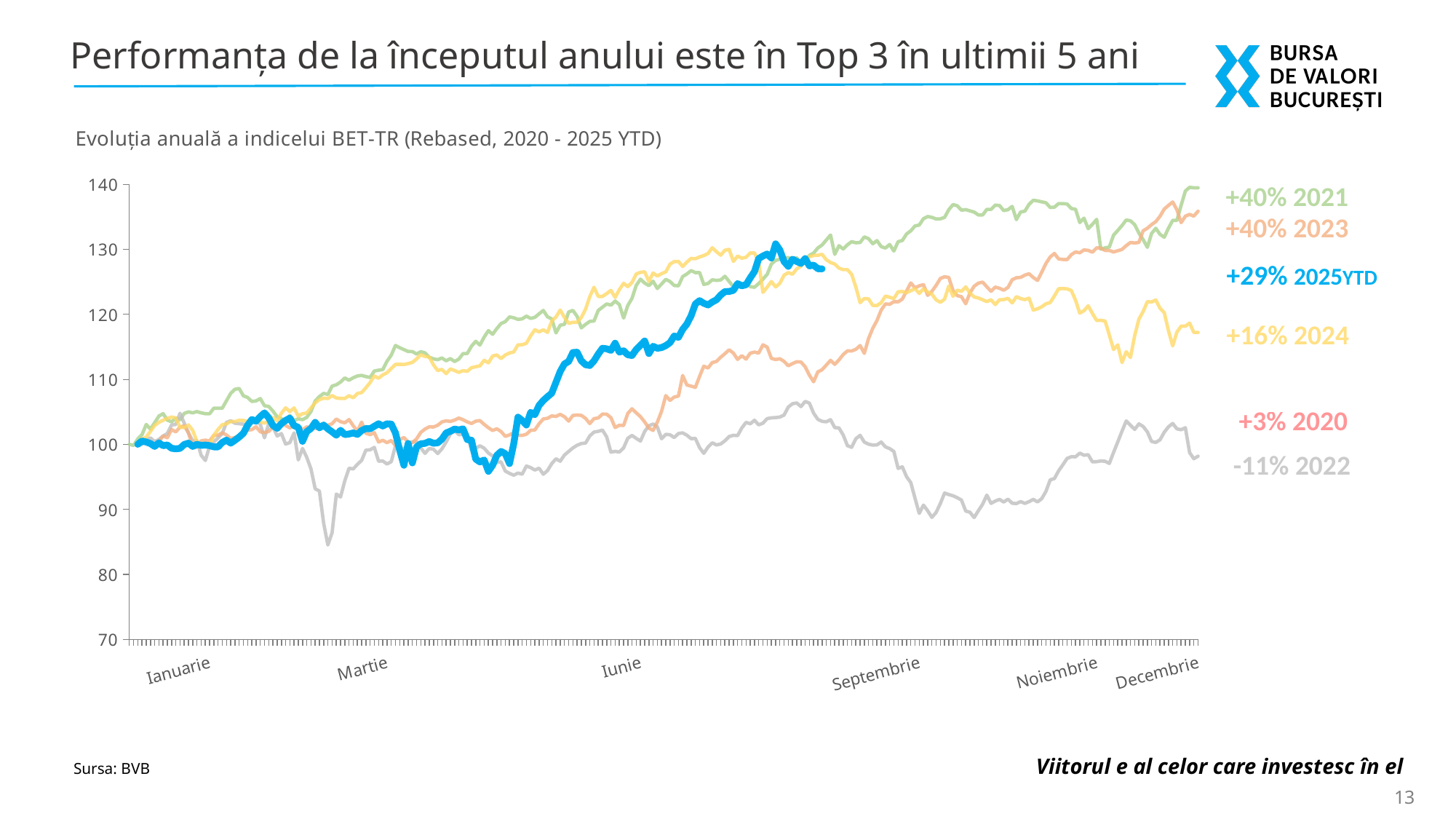
What performance is shown for 2022? -11% Which is larger, the performance for 2024 or for 2020? 2024 What performance is shown for 2024? +16% What is the year-to-date performance shown for 2025? +29% What annual performance is shown for 2021? +40% Which year has the lowest performance shown on the chart? 2022 What is the title of the chart? Evoluția anuală a indicelui BET-TR (Rebased, 2020 - 2025 YTD) How many years (series) are plotted on the chart? 6 What is the difference in percentage points between the 2021 performance and the 2024 performance? 24 percentage points What type of chart is shown on the slide? Line chart Is the lowest point of the 2022 line, around March, greater or less than 90? less Is the value of the 2021 line at the end of December greater or less than 130? greater